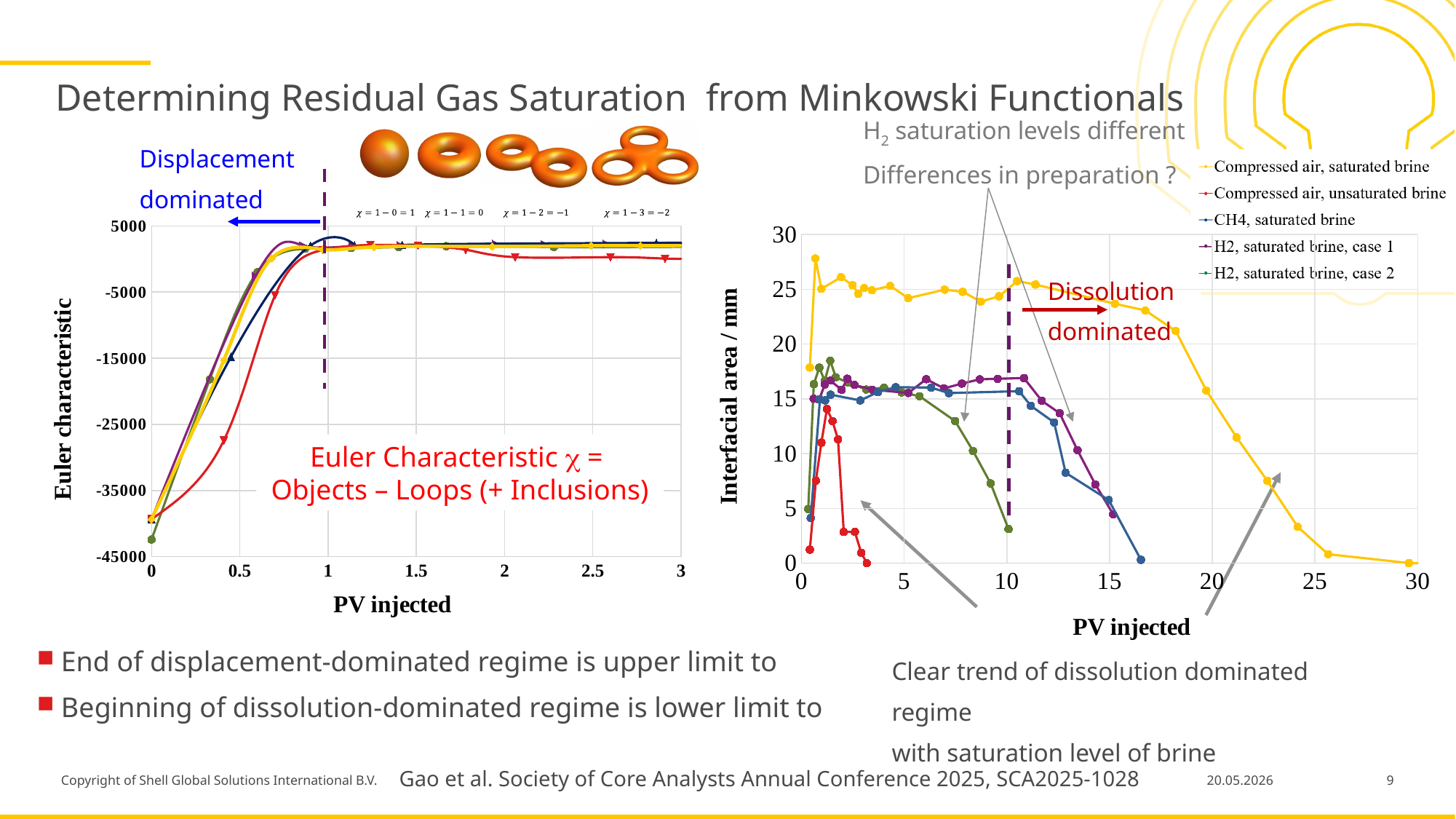
In the right-hand chart (Interfacial area / mm), is the value for 'Compressed air, saturated brine' at 5 PV injected greater or less than 20? greater In the right-hand chart (Interfacial area / mm), how many series does the legend list? 5 What kind of chart is the right-hand chart with the y-axis 'Interfacial area / mm'? line chart In the right-hand chart (Interfacial area / mm), which series reaches the highest interfacial area? Compressed air, saturated brine In the left-hand chart (Euler characteristic), do the curves rise or fall between 0 and 1 PV injected? rise In the right-hand chart (Interfacial area / mm), is the value for 'CH4, saturated brine' at 5 PV injected greater or less than 10? greater In the right-hand chart (Interfacial area / mm), does the 'Compressed air, saturated brine' series rise or fall between 20 and 30 PV injected? fall What is the x-axis label of the right-hand chart (Interfacial area / mm)? PV injected In the right-hand chart (Interfacial area / mm), at 5 PV injected, which series has the larger value: 'Compressed air, saturated brine' or 'CH4, saturated brine'? Compressed air, saturated brine In the left-hand chart (Euler characteristic), are the values at 0 PV injected greater or less than -35000? less What kind of chart is the left-hand chart with the y-axis 'Euler characteristic'? line chart In the right-hand chart (Interfacial area / mm), which series drops to zero interfacial area at the smallest PV injected? Compressed air, unsaturated brine